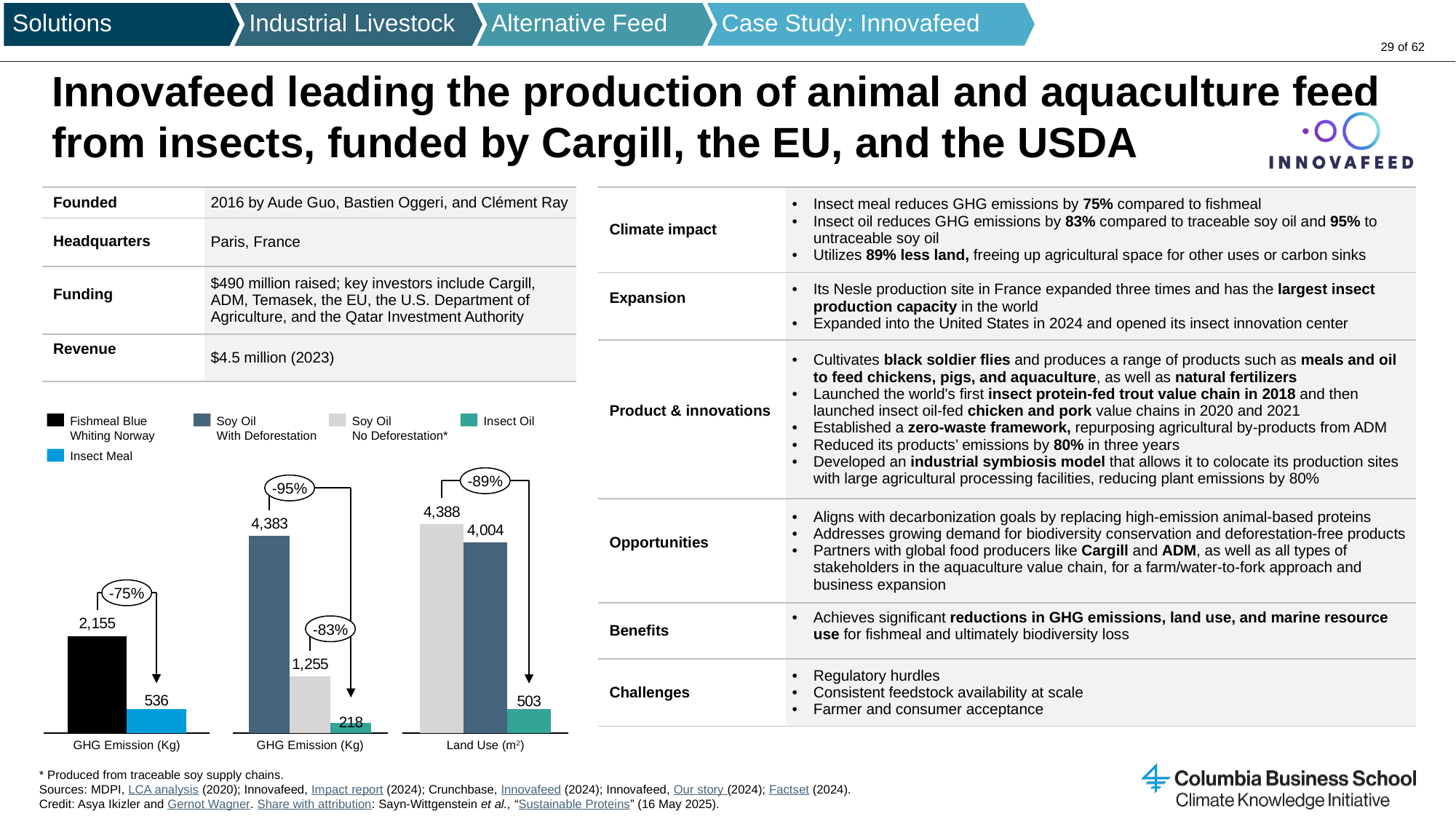
What kind of chart is used to show the GHG Emission and Land Use comparisons? Bar chart In the Land Use (m²) chart, what is the value for Insect Oil? 503 What percentage reduction is annotated between Soy Oil With Deforestation and Insect Oil in the middle GHG Emission (Kg) chart? -95% In the Land Use (m²) chart, which is larger: Soy Oil No Deforestation or Soy Oil With Deforestation? Soy Oil No Deforestation In the left GHG Emission (Kg) chart, what is the value for Fishmeal Blue Whiting Norway? 2,155 In the middle GHG Emission (Kg) chart, which category has the lowest value? Insect Oil In the middle GHG Emission (Kg) chart, what is the value for Soy Oil With Deforestation? 4,383 In the left GHG Emission (Kg) chart, what is the value for Insect Meal? 536 In the left GHG Emission (Kg) chart, what is the difference between the Fishmeal Blue Whiting Norway value and the Insect Meal value? 1,619 In the Land Use (m²) chart, which category has the highest value? Soy Oil No Deforestation In the middle GHG Emission (Kg) chart, what is the value for Insect Oil? 218 How many series does the legend list? 5